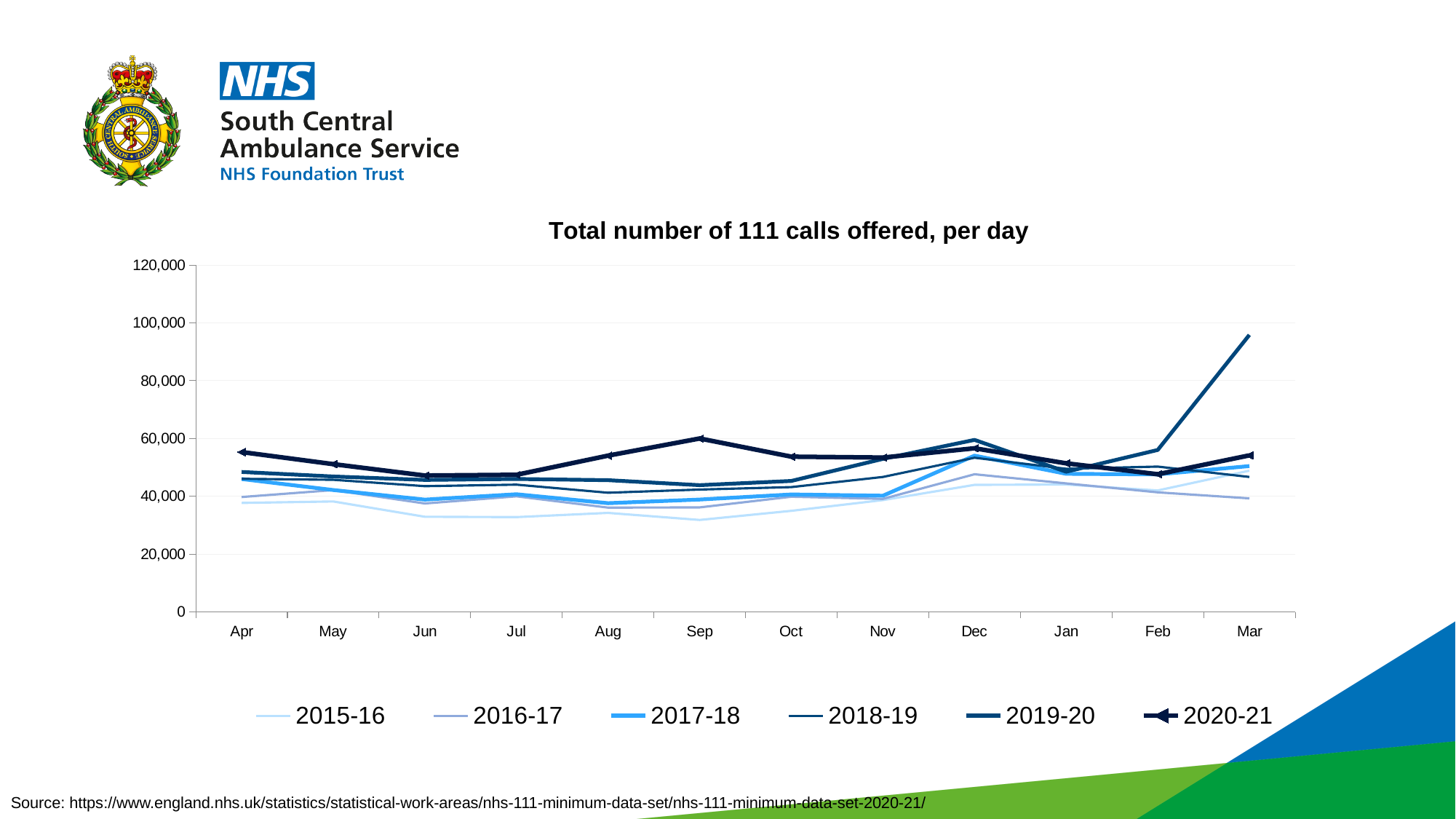
What kind of chart is shown on the slide? line chart Is the value for 2015-16 in Sep greater or less than 40,000? less Which series is drawn with markers on its line? 2020-21 Is the value for 2020-21 in Sep greater or less than 50,000? greater Does the 2020-21 series rise or fall from Apr to Jun? fall For the 2020-21 series, which month has the highest value? Sep In which month does the highest value on the chart occur? Mar Which is larger for Apr: the value for 2020-21 or the value for 2015-16? 2020-21 What is the title of the chart? Total number of 111 calls offered, per day Is the value for 2020-21 in Apr greater or less than 50,000? greater How many series does the legend list? 6 How many months are shown along the x axis? 12